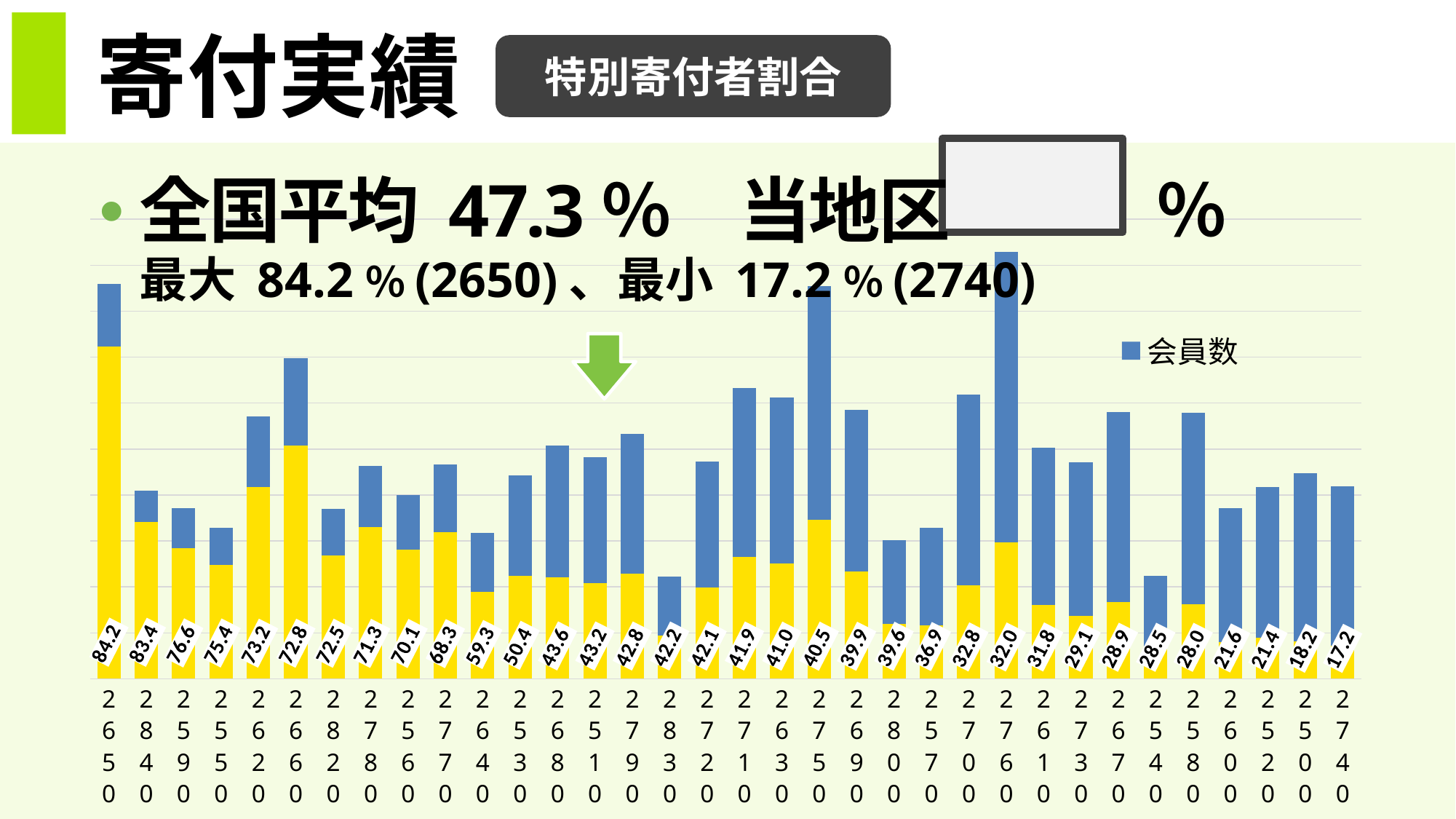
What is the data label shown for district 2840? 83.4 What kind of chart is shown on the slide? bar chart What is the data label shown for district 2650? 84.2 What is the data label shown for district 2740? 17.2 What is the data label shown for district 2510? 43.2 Which has the larger data label, district 2620 or district 2530? 2620 How many categories (districts) are plotted along the x axis? 34 Do the data label values rise or fall from left to right along the x axis? fall Which district has the highest data label value? 2650 Which district has the lowest data label value? 2740 What is the data label shown for district 2800? 39.6 What is the difference between the data labels for district 2650 and district 2740? 67.0